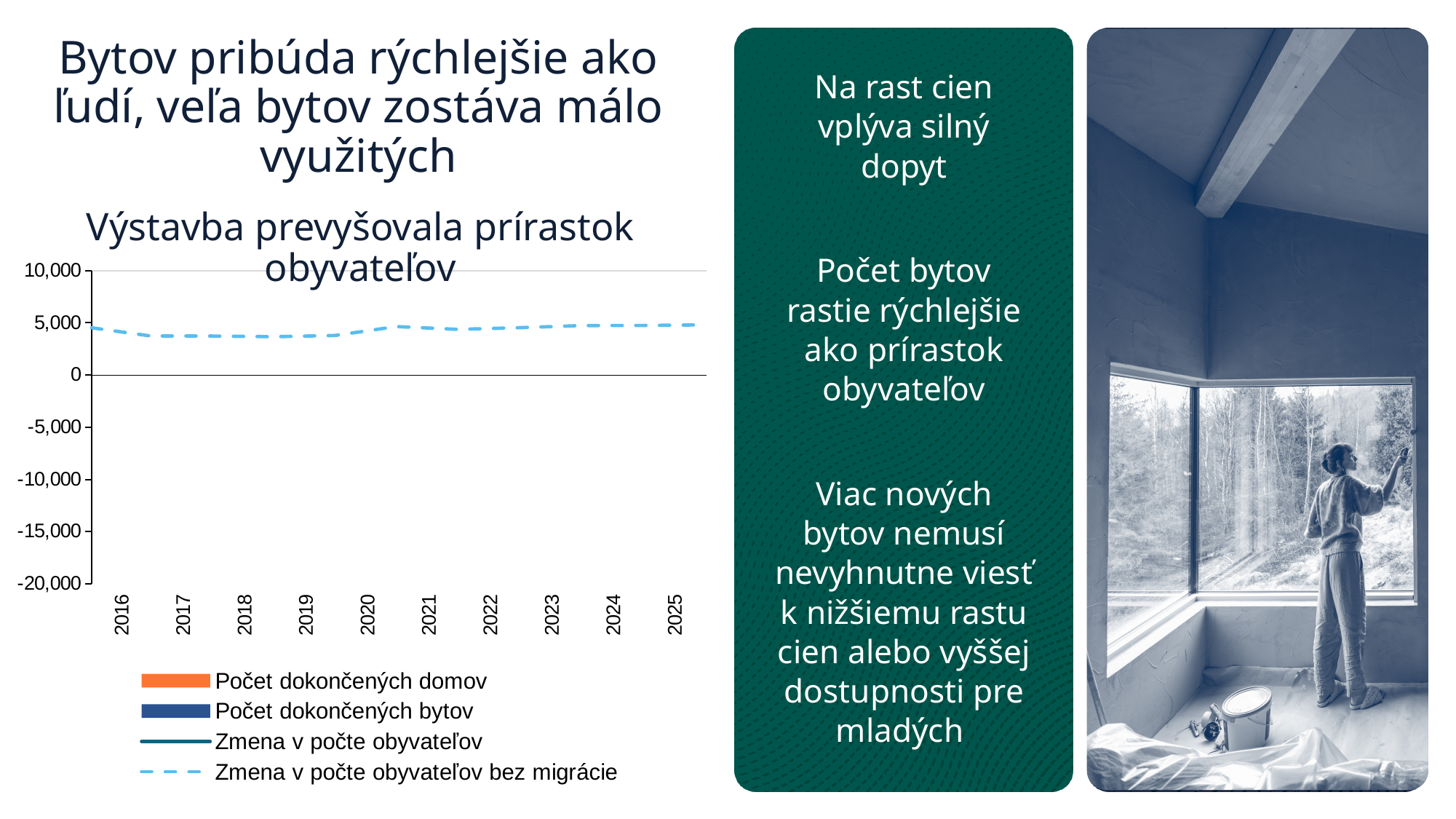
Is the value of 'Zmena v počte obyvateľov bez migrácie' for 2018 greater or less than 5,000? less What is the lowest value shown on the y axis of the chart? -20,000 Does the 'Zmena v počte obyvateľov bez migrácie' line rise or fall between 2018 and 2025? rise How many series does the chart legend list? 4 What is the first year shown on the x axis of the chart? 2016 Is the value of 'Zmena v počte obyvateľov bez migrácie' for 2025 greater or less than -5,000? greater Is the value of 'Zmena v počte obyvateľov bez migrácie' for 2020 greater or less than 10,000? less What is the title of the chart on the slide? Výstavba prevyšovala prírastok obyvateľov How many years are shown on the x axis of the chart? 10 Does the 'Zmena v počte obyvateľov bez migrácie' line rise or fall between 2016 and 2018? fall What kind of chart is plotted on the slide? combination bar and line chart